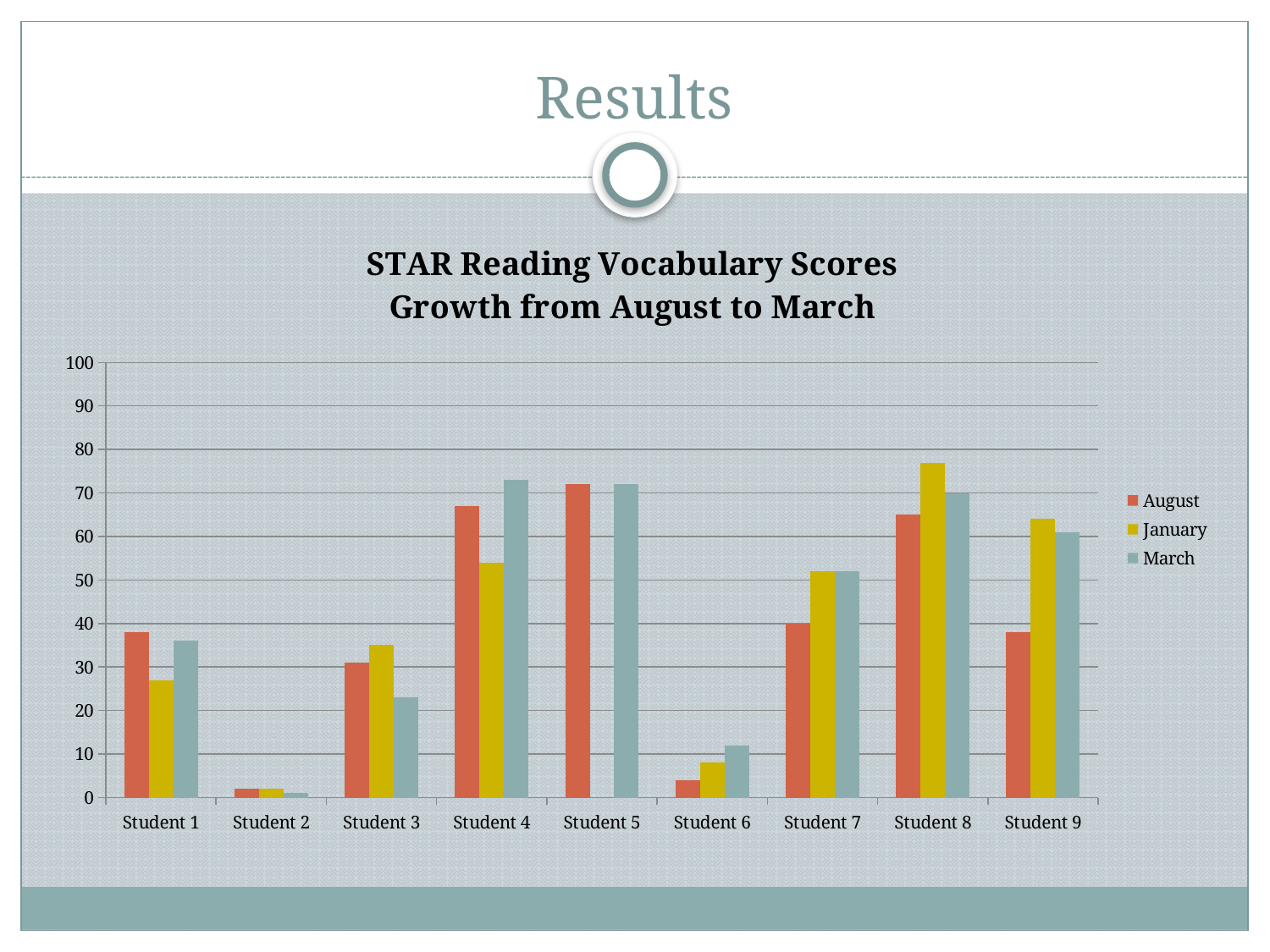
What kind of chart is shown on the slide? bar chart How many students are shown on the x axis of the chart? 9 Which student has the highest August score? Student 5 Which student has the lowest August score? Student 2 Is the March value for Student 3 greater or less than 30? less What is the title of the chart? STAR Reading Vocabulary Scores Growth from August to March Which student has the highest January score? Student 8 For Student 4, which is larger: the August score or the January score? August Is the August value for Student 7 greater or less than 50? less For Student 9, which is larger: the August score or the January score? January How many series does the chart's legend list? 3 Is the January value for Student 8 greater or less than 70? greater